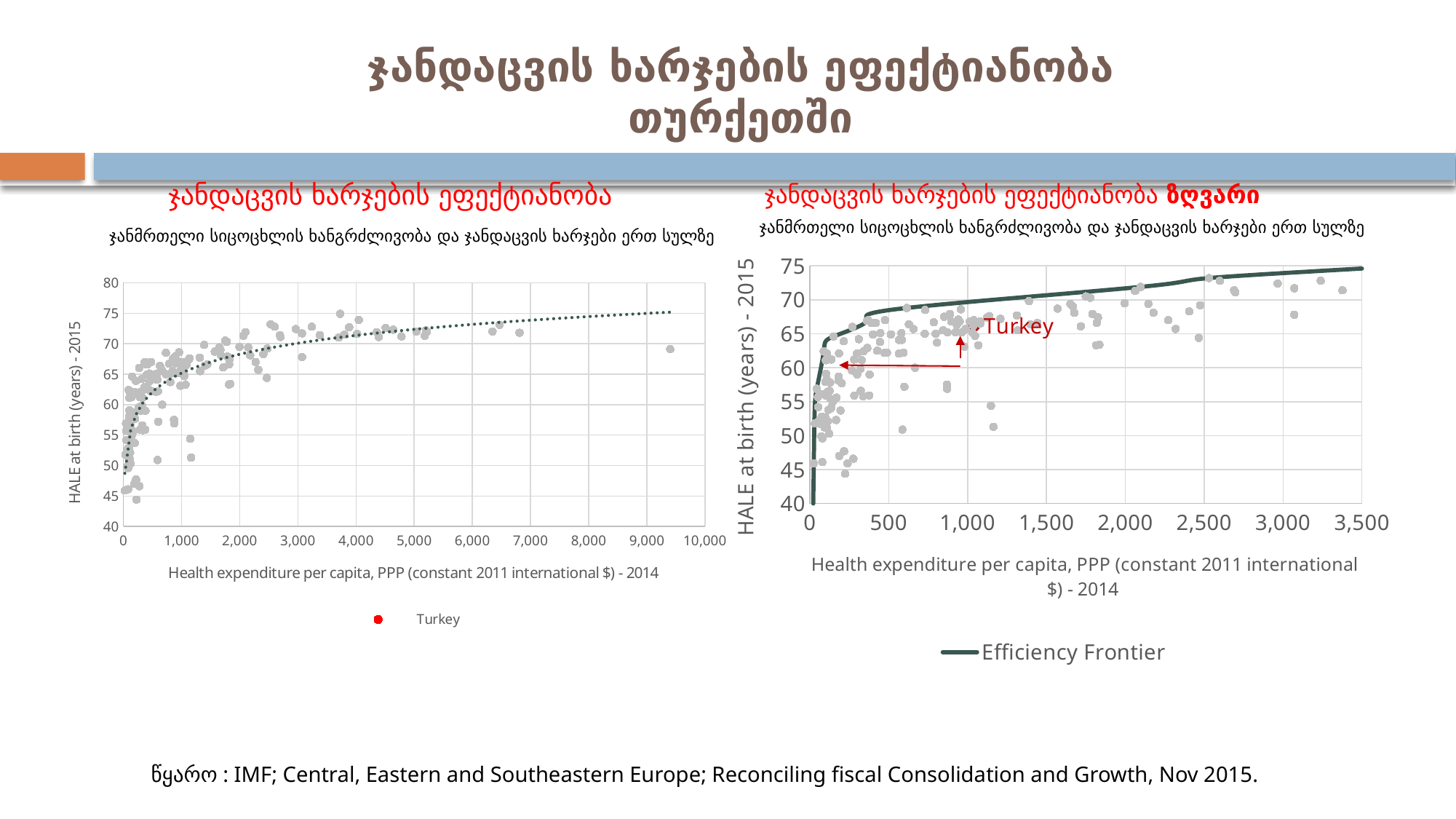
What kind of chart is the right chart on the slide? Scatter chart How many series does the legend of the right chart list? 1 In the left chart, does HALE at birth generally rise or fall as health expenditure per capita increases? Rise In the right chart, is Turkey's health expenditure per capita greater or less than 500? greater What is the legend entry shown below the left chart? Turkey What is the legend entry shown below the right chart? Efficiency Frontier In the right chart, is the HALE value for Turkey greater or less than 60? greater In the right chart, does the Efficiency Frontier line rise or fall as health expenditure per capita increases? Rise In the right chart, is the HALE value for Turkey greater or less than 70? less What kind of chart is the left chart on the slide? Scatter chart